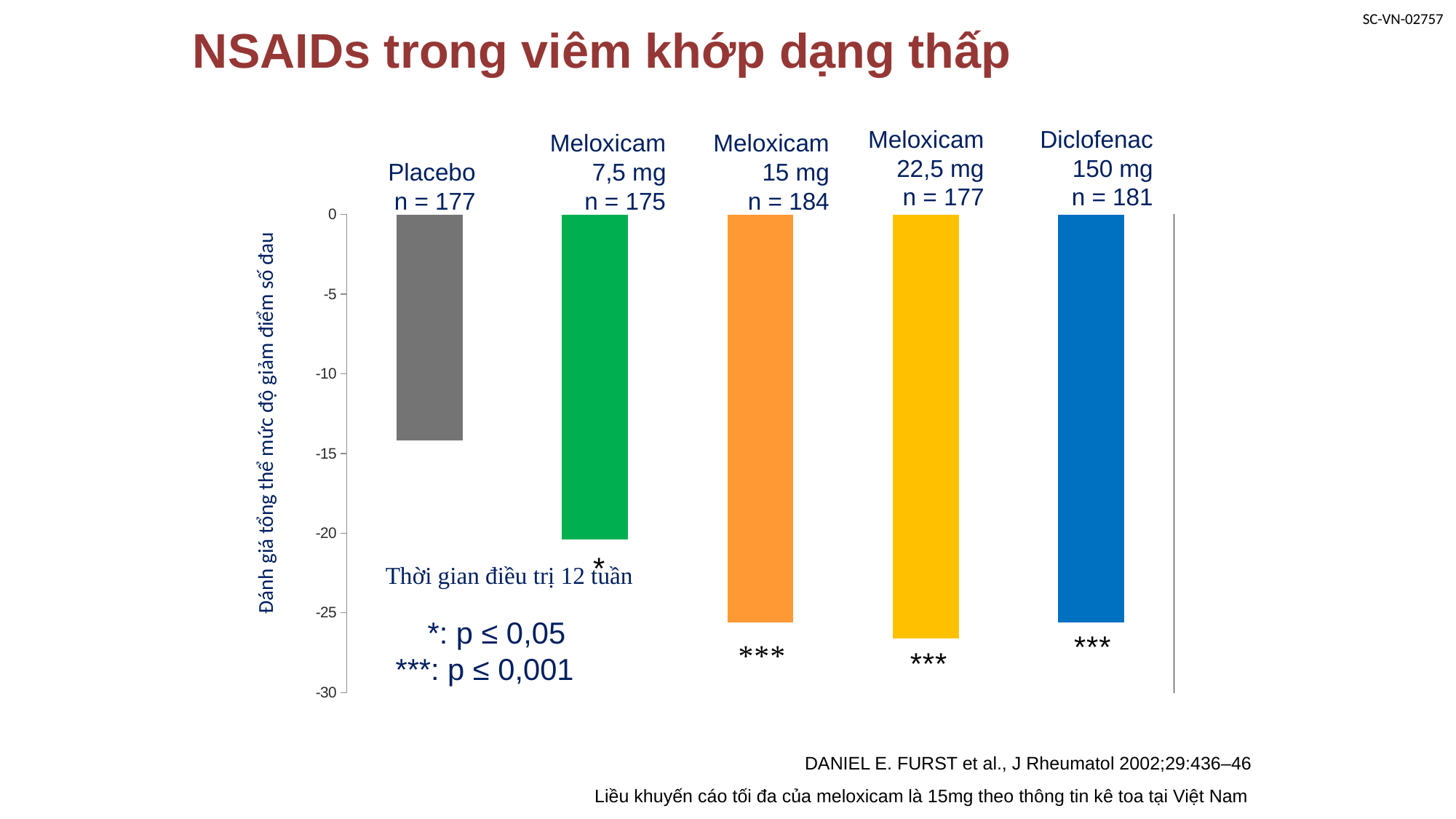
What colour is the bar for Diclofenac 150 mg? Blue How many bars (treatment groups) are plotted in the chart? 5 Which treatment group has the largest reduction in pain score (the longest bar)? Meloxicam 22,5 mg Is the value for Diclofenac 150 mg greater or less than -30? greater What is the sample size (n) shown for the Meloxicam 15 mg group? n = 184 Which shows a larger reduction in pain score: Placebo or Meloxicam 7,5 mg? Meloxicam 7,5 mg Do the values fall or rise going from Placebo through Meloxicam 7,5 mg, 15 mg to 22,5 mg? fall What kind of chart is shown on the slide? Bar chart Which treatment group has the smallest reduction in pain score (the bar closest to zero)? Placebo Is the value for Meloxicam 15 mg greater or less than -20? less Is the value for Meloxicam 7,5 mg greater or less than -15? less